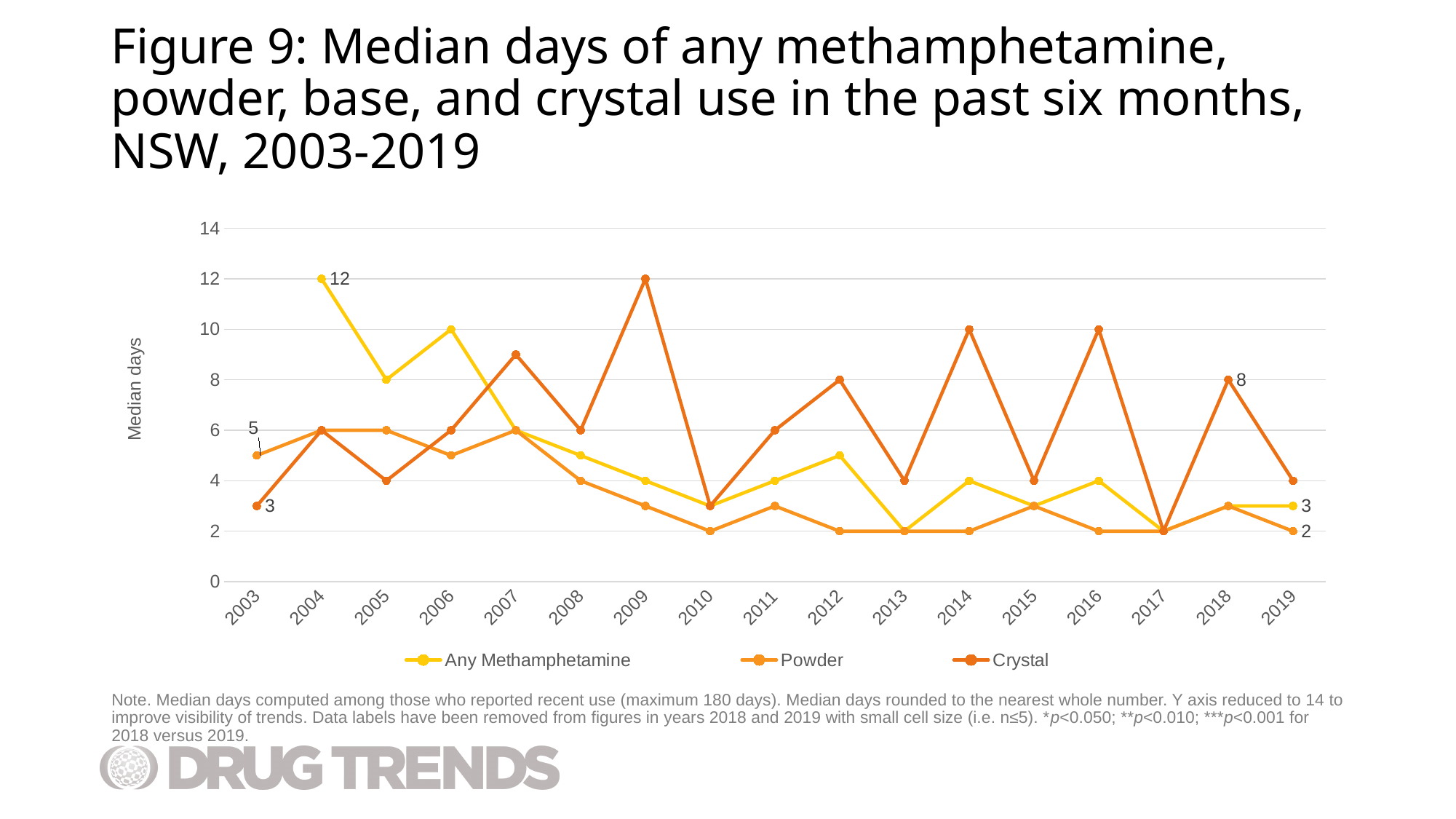
What is the median days value for Powder in 2003? 5 How many series does the legend list? 3 In which year does the Crystal series reach its highest value? 2009 Is the Crystal value in 2009 greater or less than 10? greater What is the median days value for Crystal in 2018? 8 What is the median days value for Any Methamphetamine in 2004? 12 What kind of chart is shown on the slide? line chart How many years are shown on the x axis? 17 What is the median days value for Crystal in 2003? 3 What is the median days value for Powder in 2019? 2 Which is larger: the Crystal value in 2018 or the Any Methamphetamine value in 2019? Crystal in 2018 What is the difference between the Powder and Crystal median days values in 2003? 2